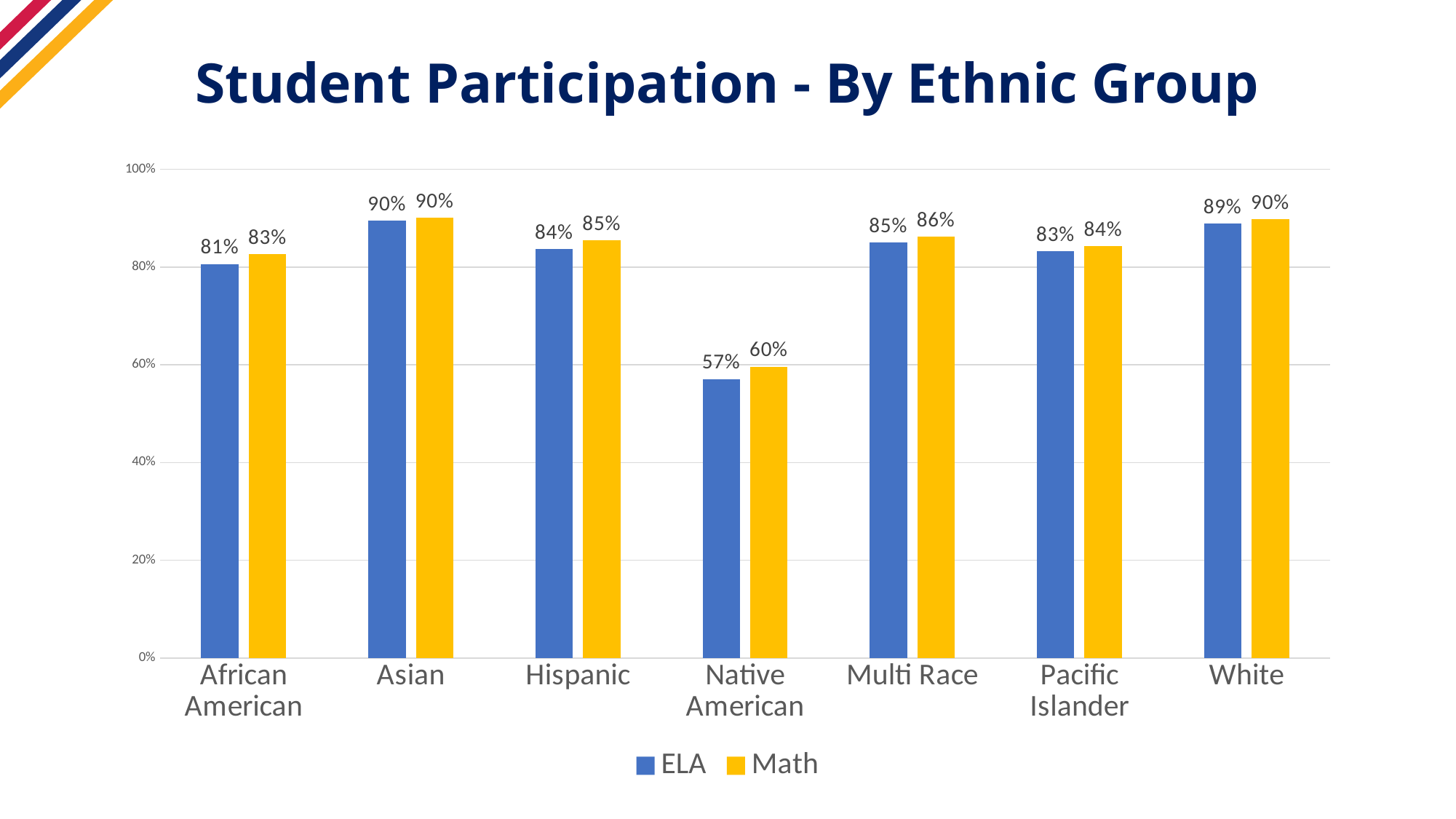
What is the Math participation rate for Multi Race students? 86% What is the difference between the Math and ELA participation rates for Native American students? 3% How many ethnic groups are shown on the x axis? 7 What type of chart is shown on the slide? Bar chart Is the ELA participation rate for Native American students greater or less than 60%? less Which ethnic group has the lowest Math participation rate? Native American What is the ELA participation rate for Native American students? 57% Which is larger, the ELA participation rate for Hispanic students or for Pacific Islander students? Hispanic What is the difference between the ELA participation rates for Asian and African American students? 9% How many series does the legend list? 2 What is the ELA participation rate for White students? 89% Which ethnic group has the highest ELA participation rate? Asian